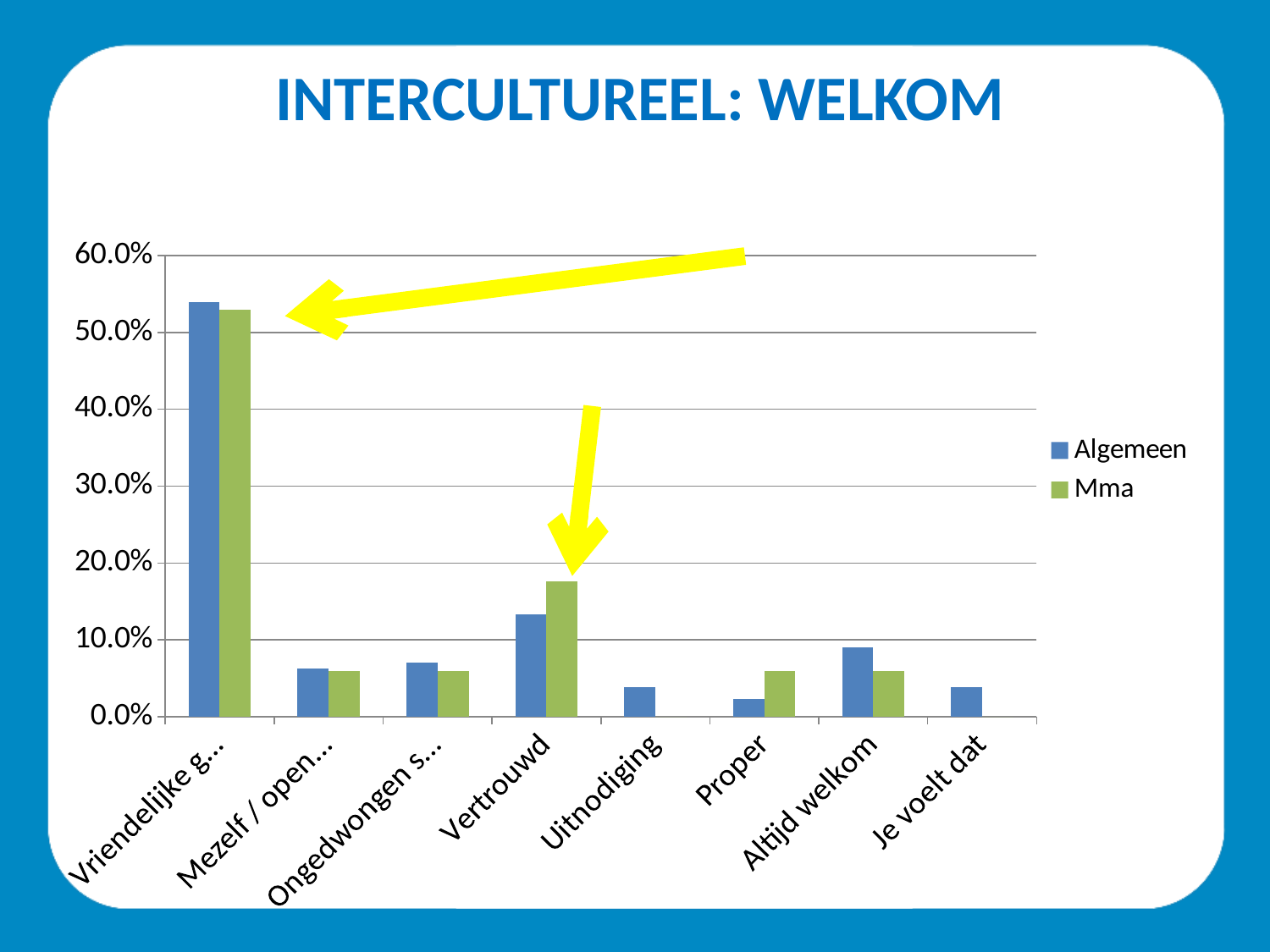
For Altijd welkom, which series has the larger value, Algemeen or Mma? Algemeen Among Vertrouwd, Uitnodiging, Proper, Altijd welkom and Je voelt dat, which category has the highest Algemeen value? Vertrouwd What kind of chart is shown on the slide? bar chart Is the Algemeen value for Vertrouwd greater or less than 10.0%? greater For Vertrouwd, which series has the larger value, Algemeen or Mma? Mma Is the Mma value for Vertrouwd greater or less than 20.0%? less Is the Algemeen value for the leftmost category greater or less than 50.0%? greater How many categories are shown on the x axis? 8 What is the title of the slide containing the chart? INTERCULTUREEL: WELKOM What are the two series named in the legend? Algemeen and Mma How many series does the legend list? 2